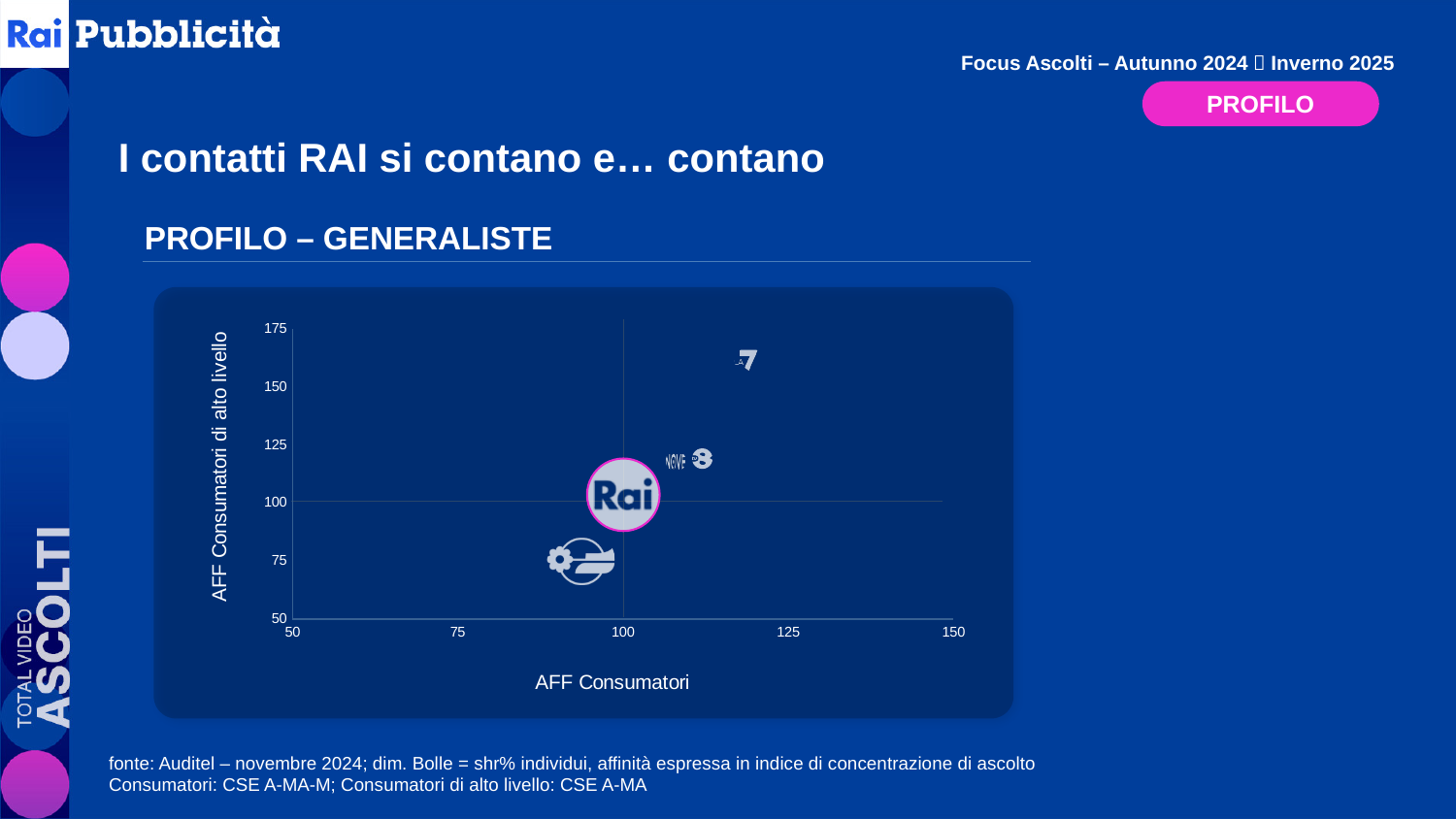
Is the AFF Consumatori di alto livello value for Mediaset greater or less than 100? less Which has a higher AFF Consumatori di alto livello value, La7 or Mediaset? La7 Is the AFF Consumatori value for La7 greater or less than 100? greater What kind of chart is shown on the slide? Bubble (scatter) chart Is the AFF Consumatori di alto livello value for La7 greater or less than 150? greater What is the title of the x axis of the chart? AFF Consumatori What is the title of the y axis of the chart? AFF Consumatori di alto livello Which broadcaster's bubble is highest on the y axis (AFF Consumatori di alto livello)? La7 Which broadcaster's bubble is lowest on the y axis (AFF Consumatori di alto livello)? Mediaset Which has a higher AFF Consumatori value, La7 or Mediaset? La7